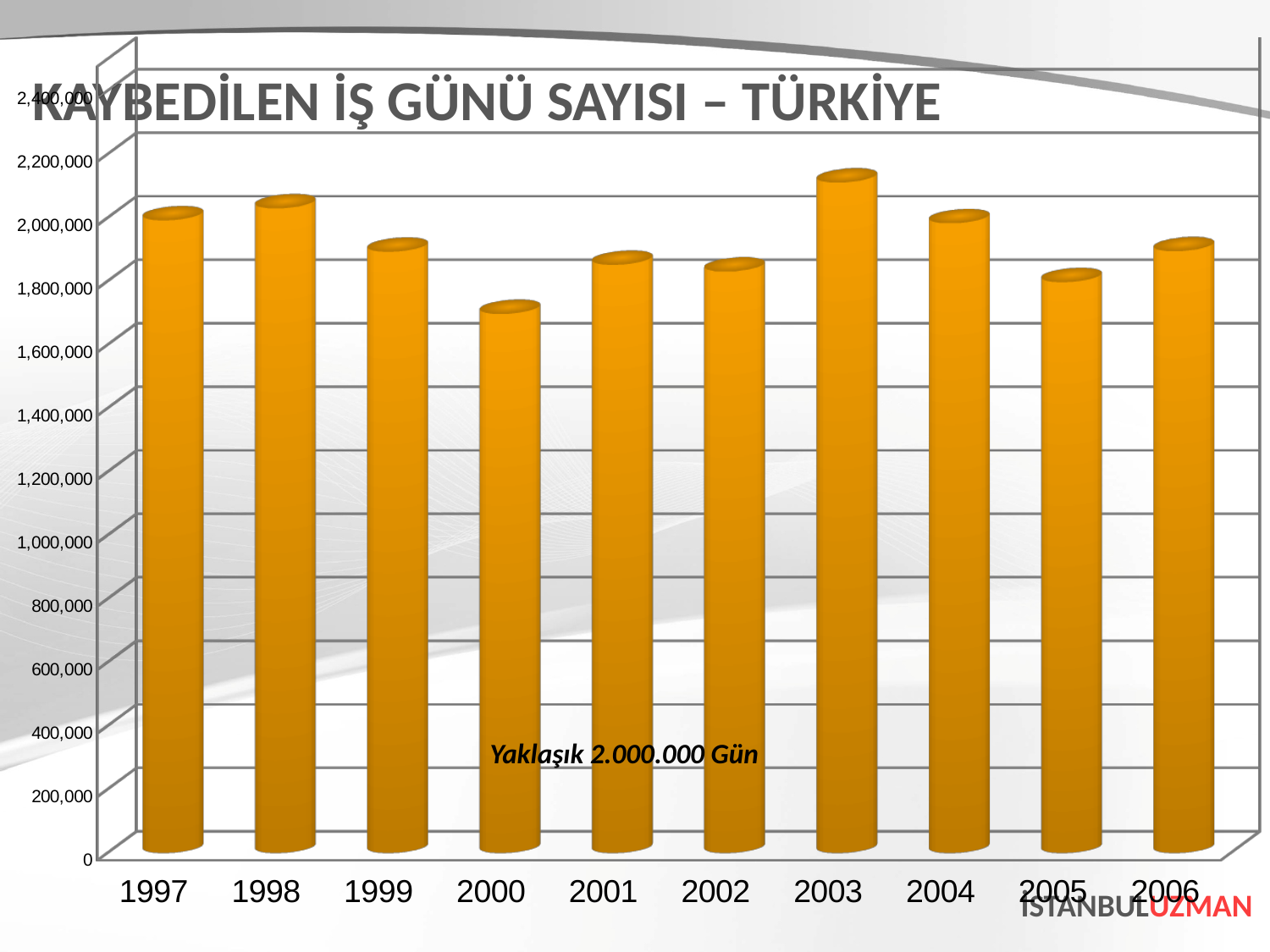
Which year has the larger value, 2003 or 2005? 2003 Do the values rise or fall from 2000 to 2003? rise Is the value for 1999 greater or less than 2,000,000? less Is the value for 2000 greater or less than 1,800,000? less Which year has the lowest number of lost work days? 2000 How many years are shown on the x axis of the chart? 10 Is the value for 2001 greater or less than 1,800,000? greater What kind of chart is shown on the slide? bar chart Which year has the larger value, 1998 or 2000? 1998 Which year has the highest number of lost work days? 2003 What is the title of the chart? KAYBEDİLEN İŞ GÜNÜ SAYISI – TÜRKİYE